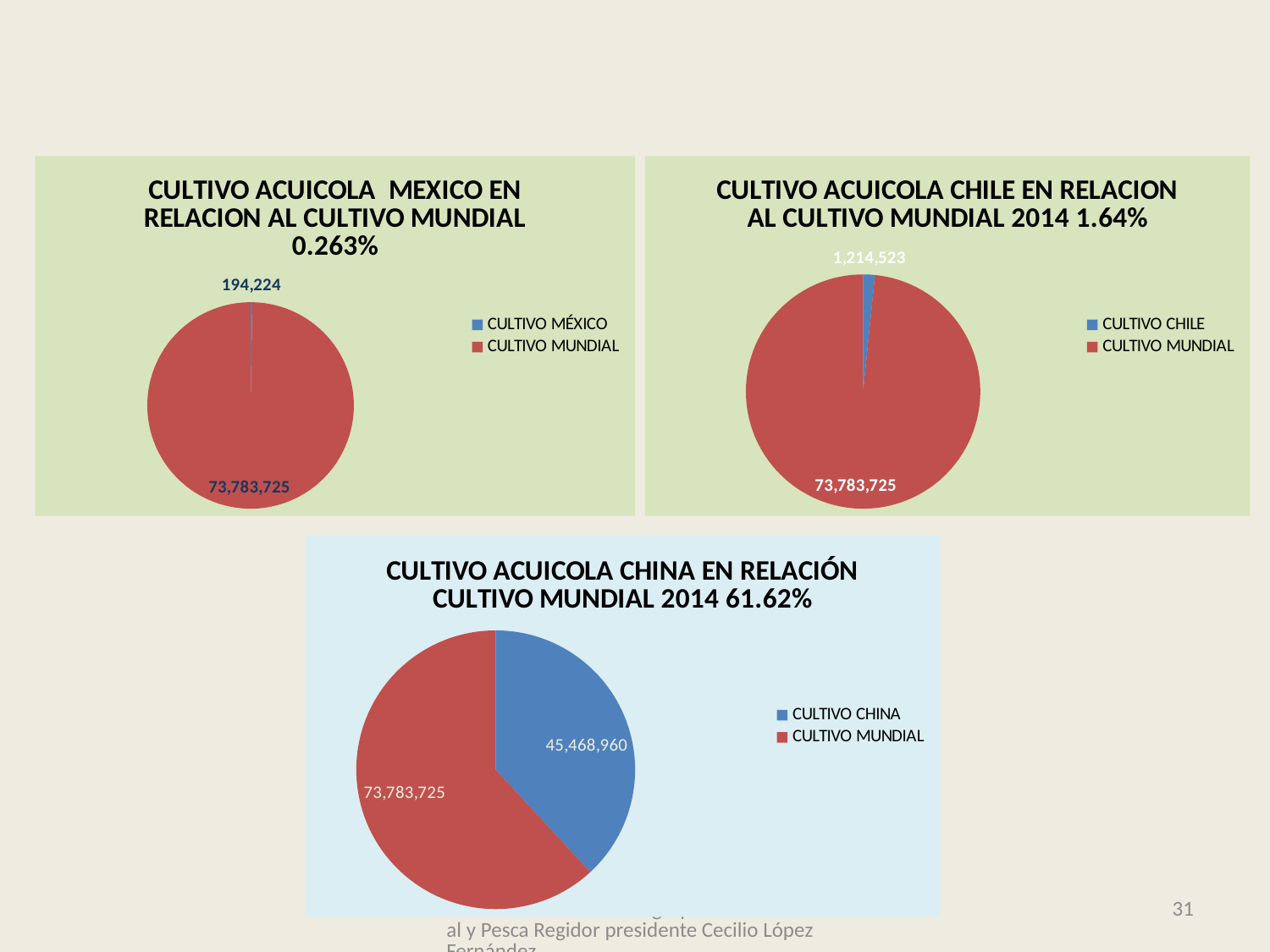
In the chart titled 'CULTIVO ACUICOLA CHILE EN RELACION AL CULTIVO MUNDIAL 2014', what is the value for CULTIVO CHILE? 1,214,523 What percentage is stated in the title of the bottom chart about China? 61.62% What type of chart is the top-left chart about Mexico? Pie chart In the top-left chart about Mexico, which category has the largest slice? CULTIVO MUNDIAL In the bottom chart about China, what is the difference between CULTIVO MUNDIAL and CULTIVO CHINA? 28,314,765 In the bottom chart about China, what is the value for CULTIVO MUNDIAL? 73,783,725 In the top-right chart about Chile, what is the difference between CULTIVO MUNDIAL and CULTIVO CHILE? 72,569,202 In the chart titled 'CULTIVO ACUICOLA MEXICO EN RELACION AL CULTIVO MUNDIAL', what is the value for CULTIVO MÉXICO? 194,224 In the chart titled 'CULTIVO ACUICOLA CHINA EN RELACIÓN CULTIVO MUNDIAL 2014', what is the value for CULTIVO CHINA? 45,468,960 In the bottom chart about China, which slice is larger, CULTIVO CHINA or CULTIVO MUNDIAL? CULTIVO MUNDIAL How many entries does the legend of the top-left chart about Mexico list? 2 In the top-right chart about Chile, which category has the smallest slice? CULTIVO CHILE